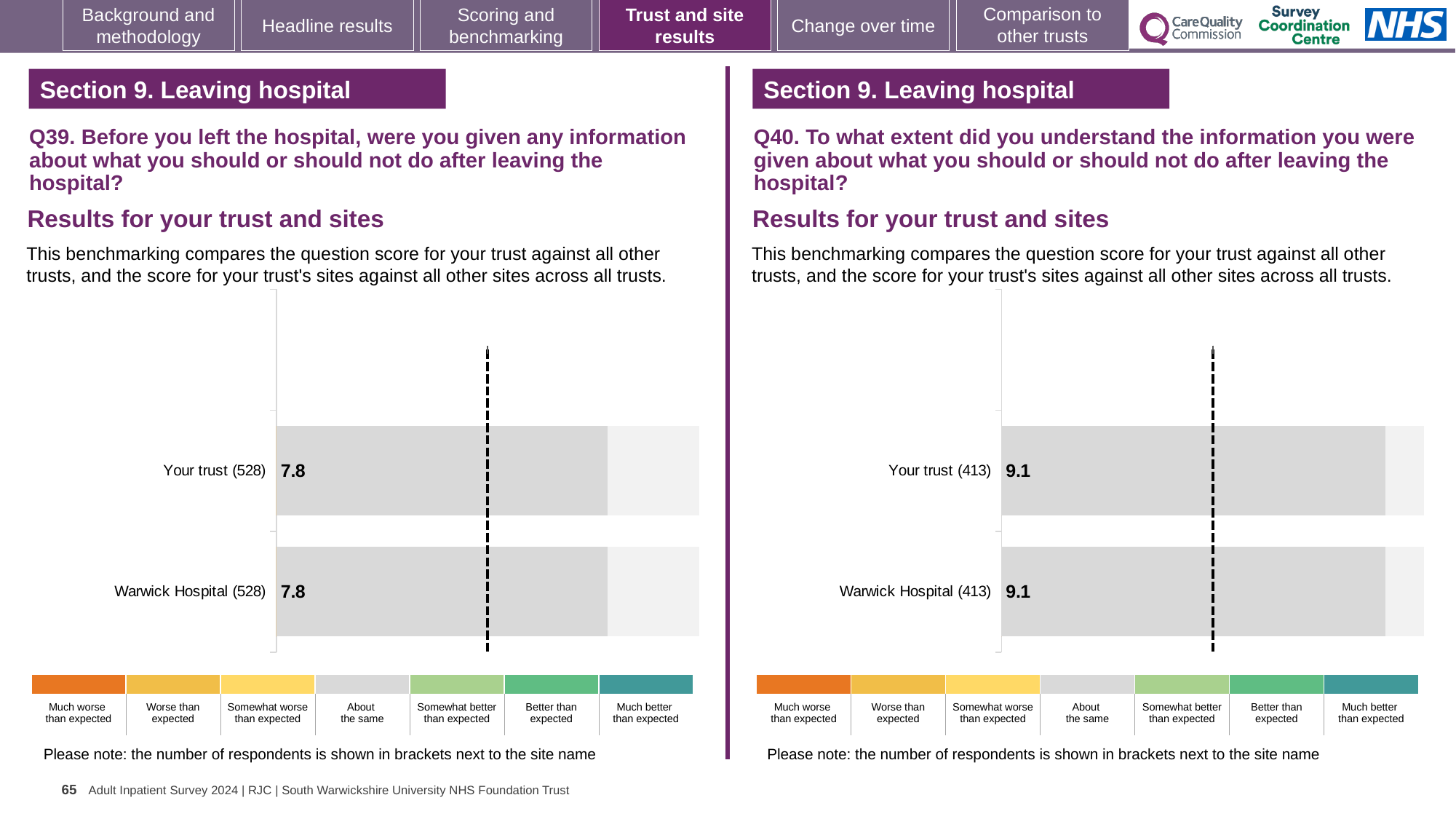
What kind of chart is used for the Q39 results on the left? Bar chart In the Q40 chart on the right, how many respondents are shown in brackets next to Warwick Hospital? 413 How many benchmark categories does the colour key below the Q40 chart on the right list? 7 In the Q40 chart on the right, what is the difference between the score for Your trust and the score for Warwick Hospital? 0 How many bars are plotted in the Q39 chart on the left? 2 How many bars are plotted in the Q40 chart on the right? 2 In the Q40 chart on the right, what is the score for Warwick Hospital? 9.1 In the Q40 chart on the right, what is the score for Your trust? 9.1 In the Q39 chart on the left, what is the difference between the score for Your trust and the score for Warwick Hospital? 0 In the Q39 chart on the left, what is the score for Your trust? 7.8 In the Q39 chart on the left, what is the score for Warwick Hospital? 7.8 In the Q39 chart on the left, how many respondents are shown in brackets next to Your trust? 528